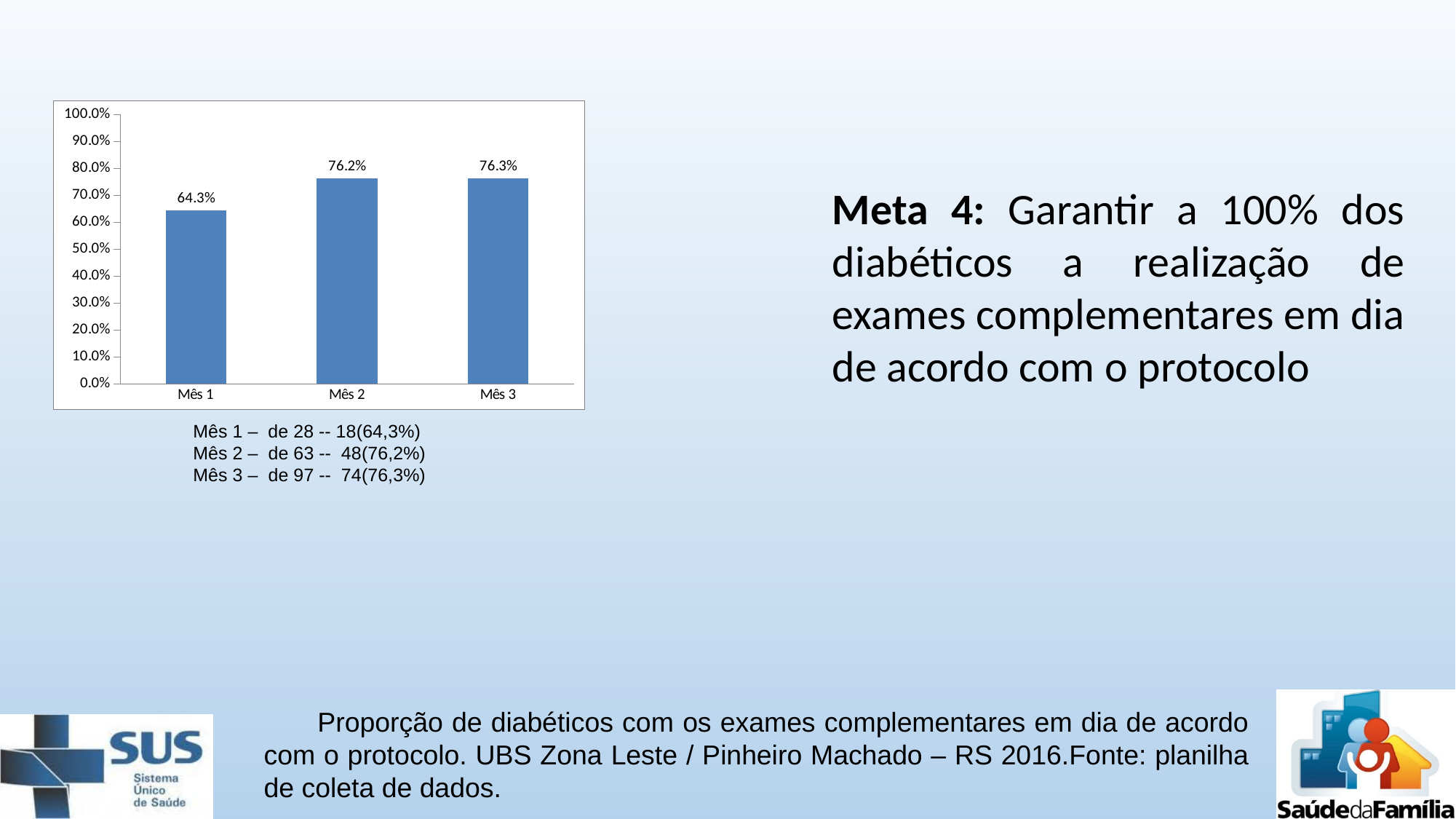
How many months are shown on the x axis? 3 What is the difference between the values for Mês 3 and Mês 1? 12.0 percentage points What is the value for Mês 2? 76.2% Is the value for Mês 1 greater or less than 60%? greater What kind of chart is shown on the slide? bar chart Which is larger, the value for Mês 1 or the value for Mês 2? Mês 2 What is the value for Mês 1? 64.3% Which month has the lowest value? Mês 1 What is the difference between the values for Mês 2 and Mês 1? 11.9 percentage points Do the values rise or fall from Mês 1 to Mês 3? rise Is the value for Mês 2 greater or less than 80%? less What is the value for Mês 3? 76.3%